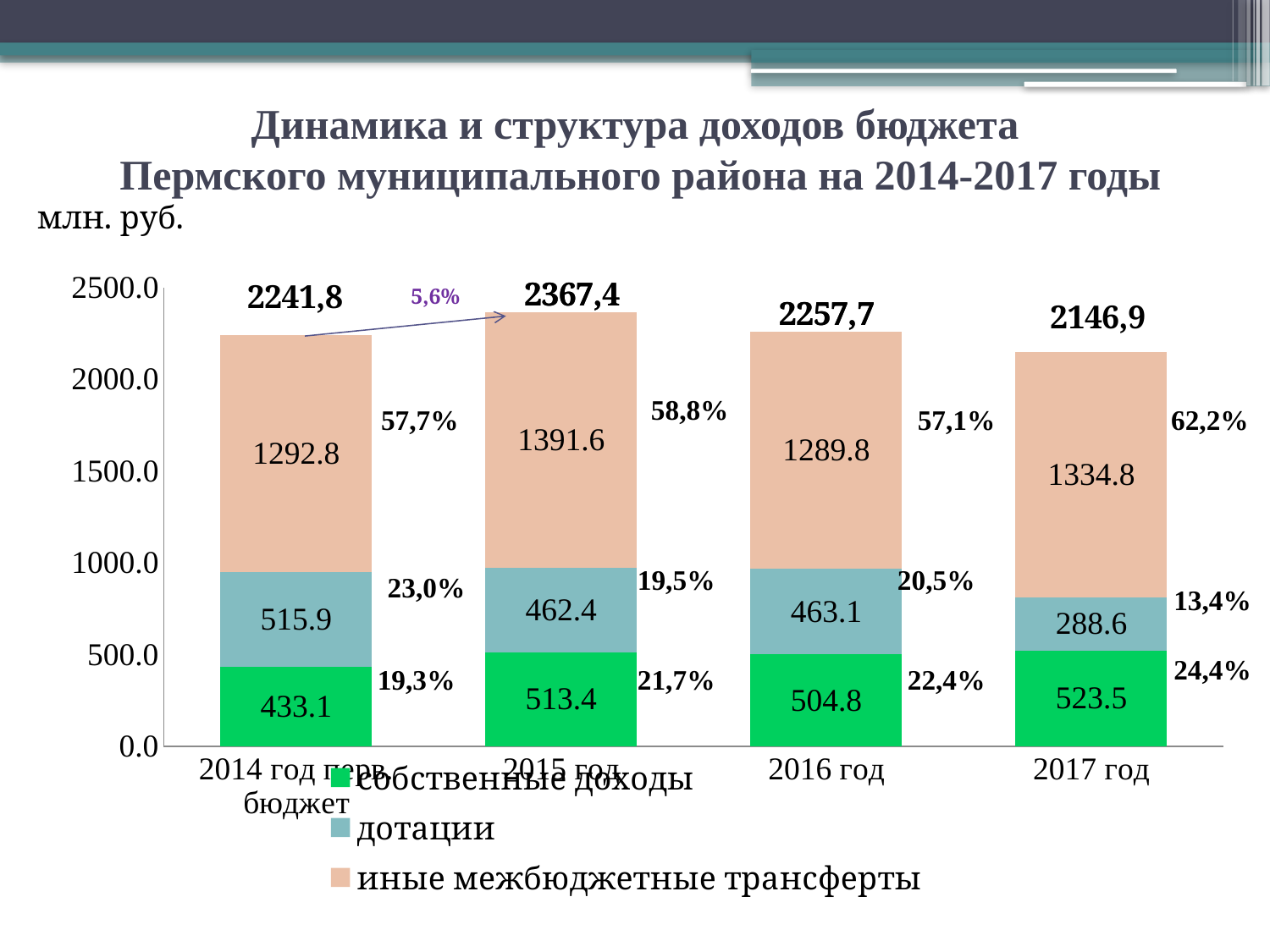
How many series does the legend list? 3 What is the value of дотации for 2017 год? 288.6 Do the values of дотации rise or fall from 2014 год to 2017 год? fall How many years (categories) are shown on the x axis? 4 Which year has the highest value for иные межбюджетные трансферты? 2015 год What is the total of the stacked bar for 2015 год, as labelled above the bar? 2367,4 What is the difference between дотации in 2014 год and 2017 год? 227.3 What is the value of иные межбюджетные трансферты for 2016 год? 1289.8 What is the value of собственные доходы for 2015 год? 513.4 Which year has the lowest value for дотации? 2017 год What type of chart is shown on the slide? stacked bar chart Which is larger: собственные доходы in 2016 год or in 2017 год? 2017 год